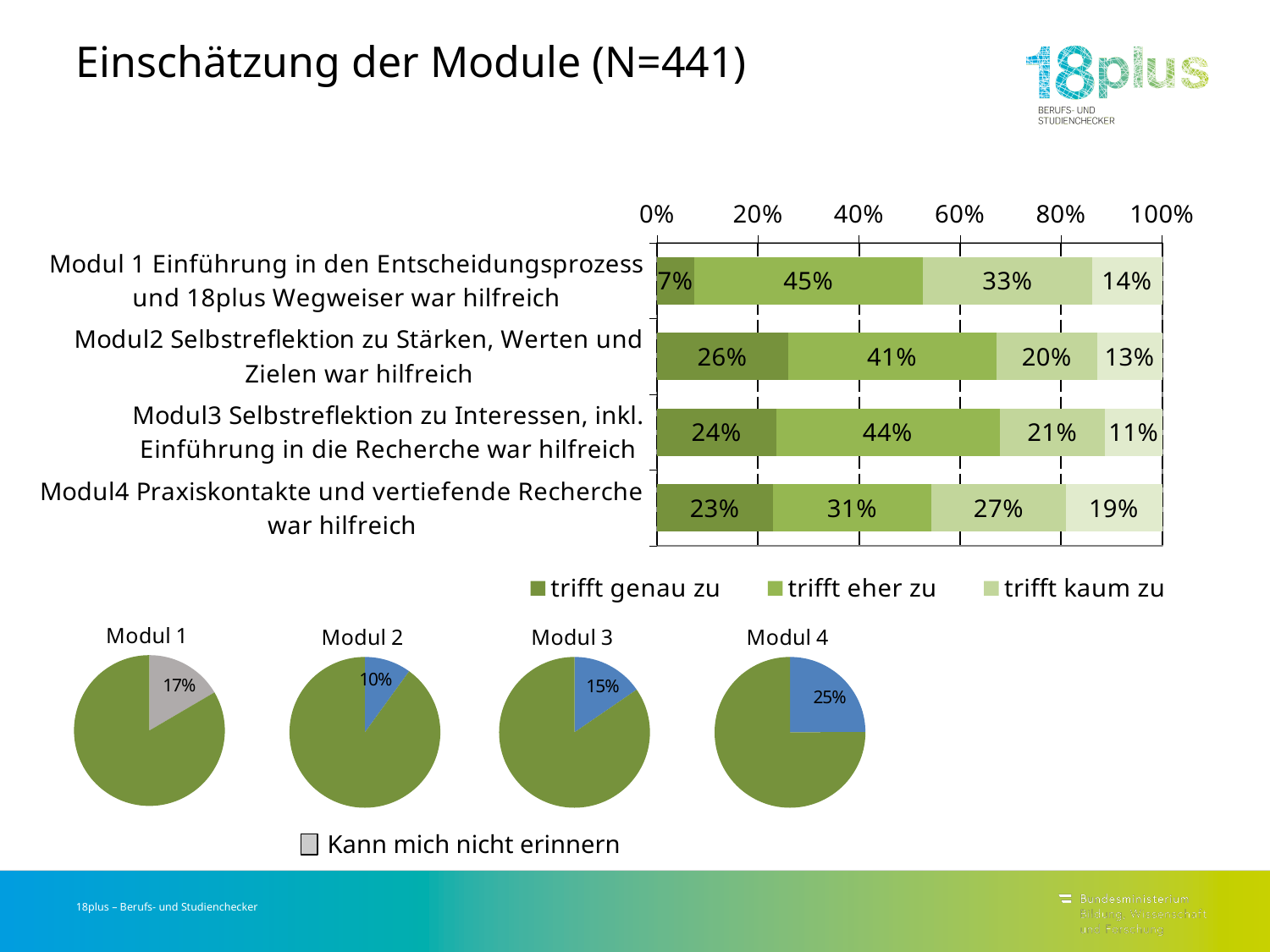
In the pie chart for Modul 4, what share is labelled for 'Kann mich nicht erinnern'? 25% What kind of chart is the upper chart on the slide? Stacked bar chart How many series does the legend of the stacked bar chart list? 3 In the stacked bar chart, what is the 'trifft eher zu' value for 'Modul 1 Einführung in den Entscheidungsprozess und 18plus Wegweiser war hilfreich'? 45% In the stacked bar chart, what is the 'trifft kaum zu' value for 'Modul4 Praxiskontakte und vertiefende Recherche war hilfreich'? 27% In the stacked bar chart, what is the 'trifft genau zu' value for 'Modul2 Selbstreflektion zu Stärken, Werten und Zielen war hilfreich'? 26% In the stacked bar chart, which module has the lowest 'trifft eher zu' value? Modul4 Praxiskontakte und vertiefende Recherche war hilfreich In the stacked bar chart, what is the difference between the 'trifft eher zu' values of Modul 3 and Modul 4? 13% Among the four pie charts, which module has the smallest 'Kann mich nicht erinnern' share? Modul 2 In the stacked bar chart, which module has the highest 'trifft genau zu' value? Modul2 Selbstreflektion zu Stärken, Werten und Zielen war hilfreich In the stacked bar chart, is the 'trifft genau zu' value larger for Modul 3 or for Modul 4? Modul 3 How many modules (categories) are shown in the stacked bar chart? 4